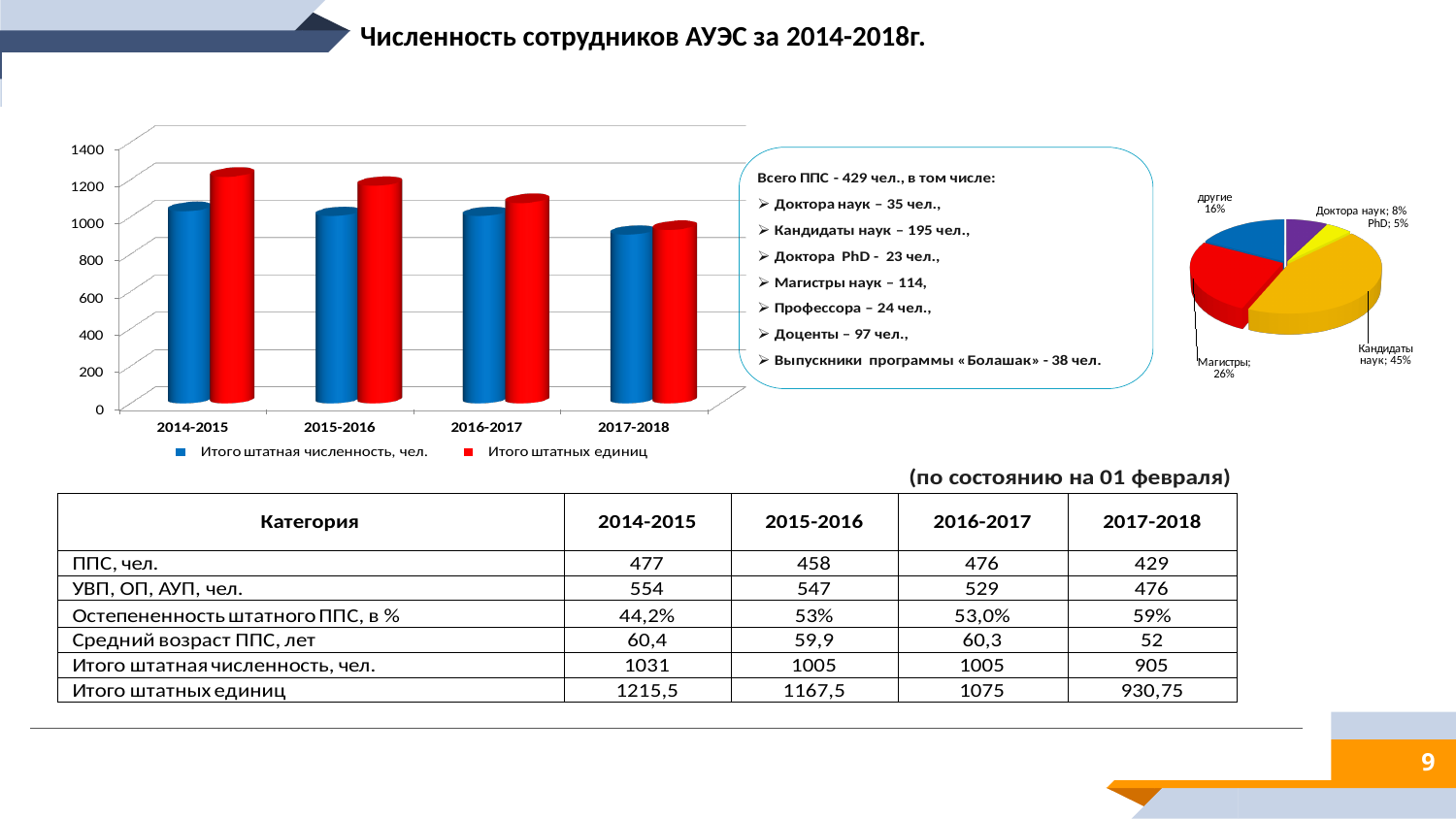
What kind of chart is the left chart on the slide? bar chart What colour is the 'Итого штатная численность, чел.' series in the left bar chart? blue In the left bar chart, which year has the lowest value for 'Итого штатных единиц'? 2017-2018 In the left bar chart, which series has the larger value for 2014-2015: 'Итого штатная численность, чел.' or 'Итого штатных единиц'? Итого штатных единиц In the left bar chart, do the values of 'Итого штатных единиц' rise or fall from 2014-2015 to 2017-2018? fall How many year categories are shown on the x axis of the left bar chart? 4 In the left bar chart, is the value of 'Итого штатных единиц' for 2014-2015 greater or less than 1200? greater In the pie chart on the right, which category has the smallest share? PhD How many series does the legend of the left bar chart list? 2 In the left bar chart, is the value of 'Итого штатная численность, чел.' for 2017-2018 greater or less than 1000? less In the pie chart on the right, what share does 'Кандидаты наук' have? 45% In the pie chart on the right, what is the difference in percentage points between 'Кандидаты наук' and 'Магистры'? 19